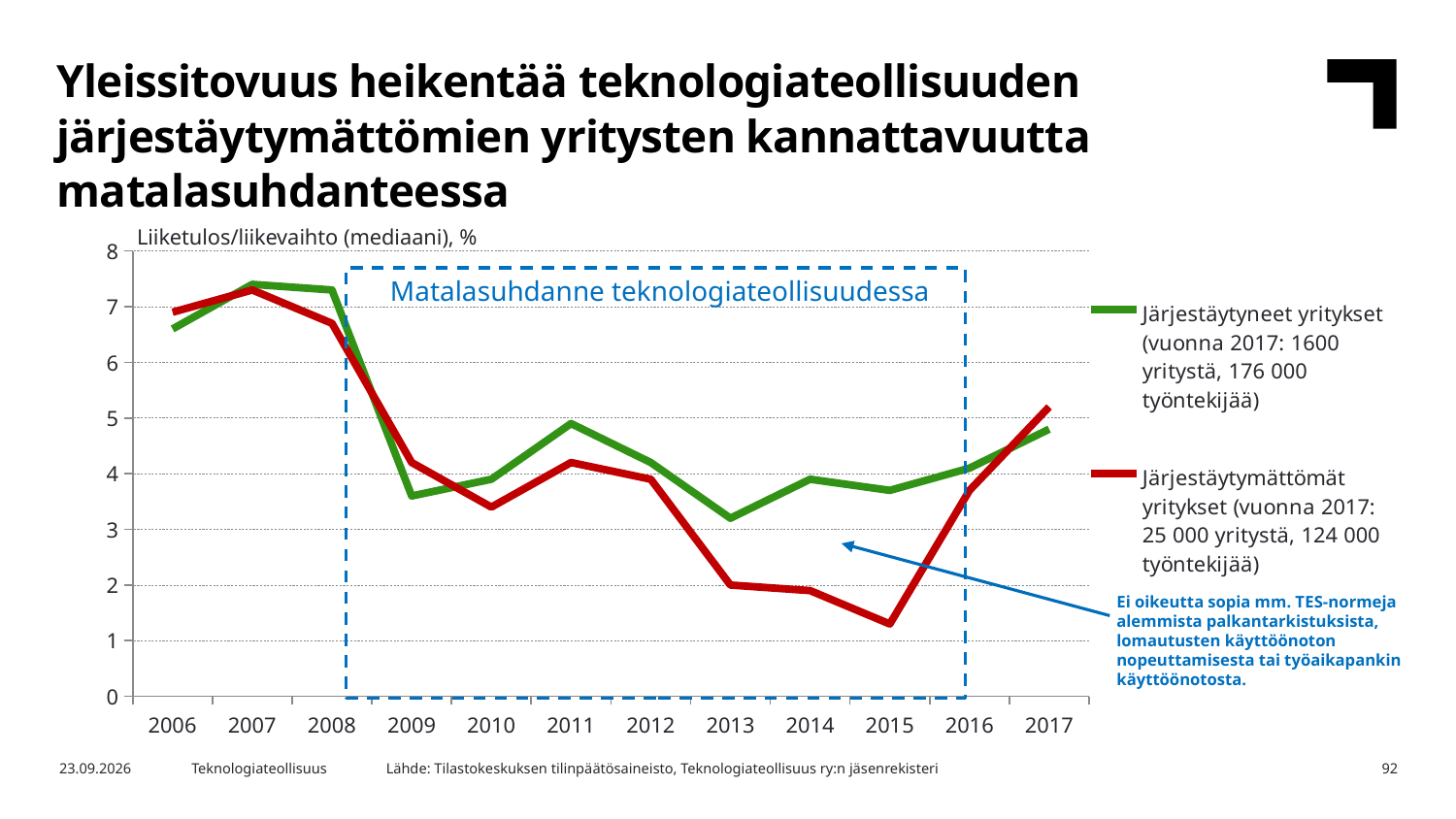
In which year is the value for Järjestäytymättömät yritykset lowest? 2015 How many years are shown on the x axis? 12 Does the value for Järjestäytymättömät yritykset rise or fall from 2012 to 2015? fall Is the value for Järjestäytyneet yritykset in 2009 greater or less than 4? less Is the value for Järjestäytyneet yritykset in 2011 greater or less than 4? greater What type of chart is shown on the slide? line chart How many series does the legend list? 2 Is the value for Järjestäytymättömät yritykset in 2015 greater or less than 2? less In which year is the value for Järjestäytymättömät yritykset highest? 2007 In 2017, which series has the higher value? Järjestäytymättömät yritykset In 2013, which series has the higher value? Järjestäytyneet yritykset What is the label shown above the y axis of the chart? Liiketulos/liikevaihto (mediaani), %